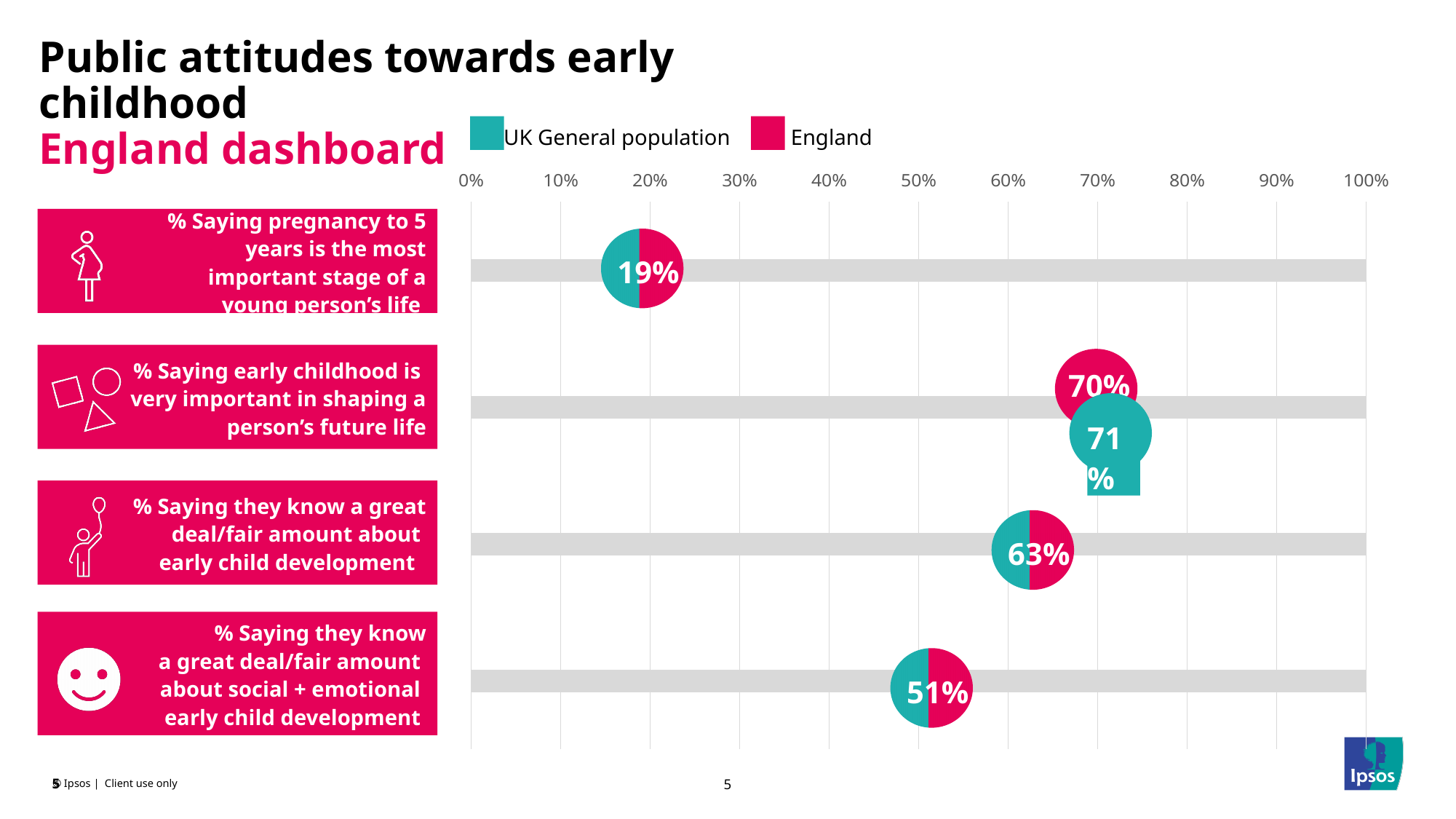
What percentage say they know a great deal/fair amount about early child development? 63% How many statements (categories) are plotted on the chart? 4 Which statement has the highest percentage on the chart? % Saying early childhood is very important in shaping a person's future life Which statement has the lowest percentage on the chart? % Saying pregnancy to 5 years is the most important stage of a young person's life What are the two series named in the legend? UK General population and England What percentage say pregnancy to 5 years is the most important stage of a young person's life? 19% Which colour represents England in the legend? Pink What percentage say they know a great deal/fair amount about social + emotional early child development? 51% What is the England value for saying early childhood is very important in shaping a person's future life? 70% What is the UK General population value for saying early childhood is very important in shaping a person's future life? 71% How many series does the legend list? 2 What is the difference between the percentage who know a great deal/fair amount about early child development (63%) and about social + emotional early child development (51%)? 12 percentage points